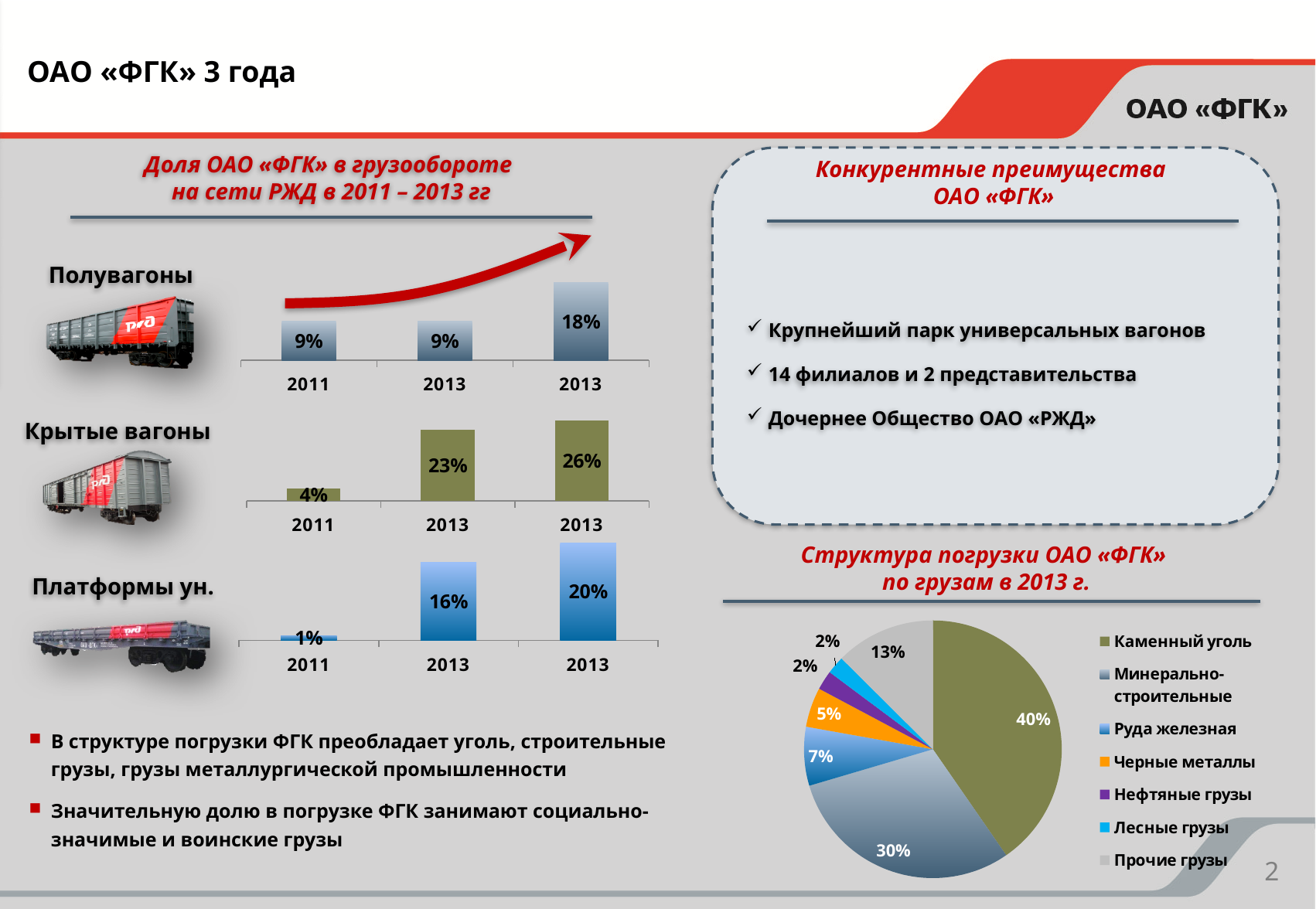
In the Полувагоны bar chart, what is the value for 2011? 9% In the Платформы ун. bar chart, do the values rise or fall from left to right? rise In the pie chart Структура погрузки ОАО «ФГК» по грузам в 2013 г., what is the share of Каменный уголь? 40% In the Полувагоны bar chart, what is the value of the rightmost bar? 18% In the Крытые вагоны bar chart, what is the value for 2011? 4% What type of chart is used for Структура погрузки ОАО «ФГК» по грузам в 2013 г.? pie chart In the pie chart Структура погрузки ОАО «ФГК» по грузам в 2013 г., which is larger: Руда железная or Черные металлы? Руда железная In the Платформы ун. bar chart, what is the value of the middle bar? 16% How many bars are in the Крытые вагоны bar chart? 3 In the pie chart Структура погрузки ОАО «ФГК» по грузам в 2013 г., which category has the largest share? Каменный уголь In the Крытые вагоны bar chart, what is the difference between the rightmost bar and the 2011 bar? 22% How many categories does the legend of the pie chart Структура погрузки ОАО «ФГК» по грузам в 2013 г. list? 7